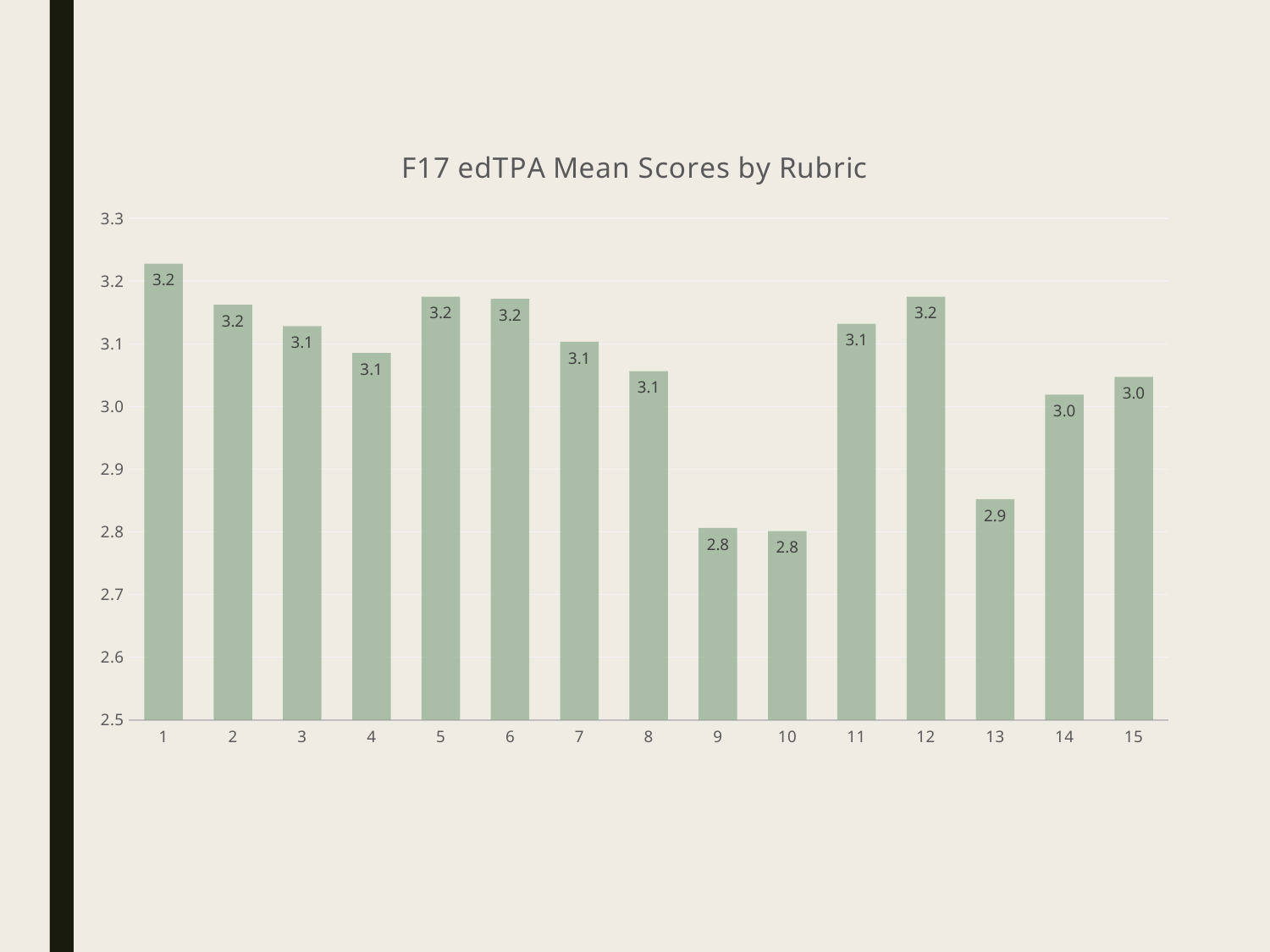
What is the mean score for rubric 13? 2.9 What kind of chart is shown on the slide? Bar chart Is the mean score for rubric 4 greater or less than 3.0? greater Which rubric has the highest mean score? 1 How many rubrics are shown on the x axis? 15 What is the difference between the mean scores for rubric 1 and rubric 9? 0.4 Which has a higher mean score, rubric 5 or rubric 10? Rubric 5 What is the title of the chart? F17 edTPA Mean Scores by Rubric What is the mean score for rubric 14? 3.0 Is the mean score for rubric 13 greater or less than 3.0? less What is the mean score for rubric 9? 2.8 What is the mean score for rubric 1? 3.2